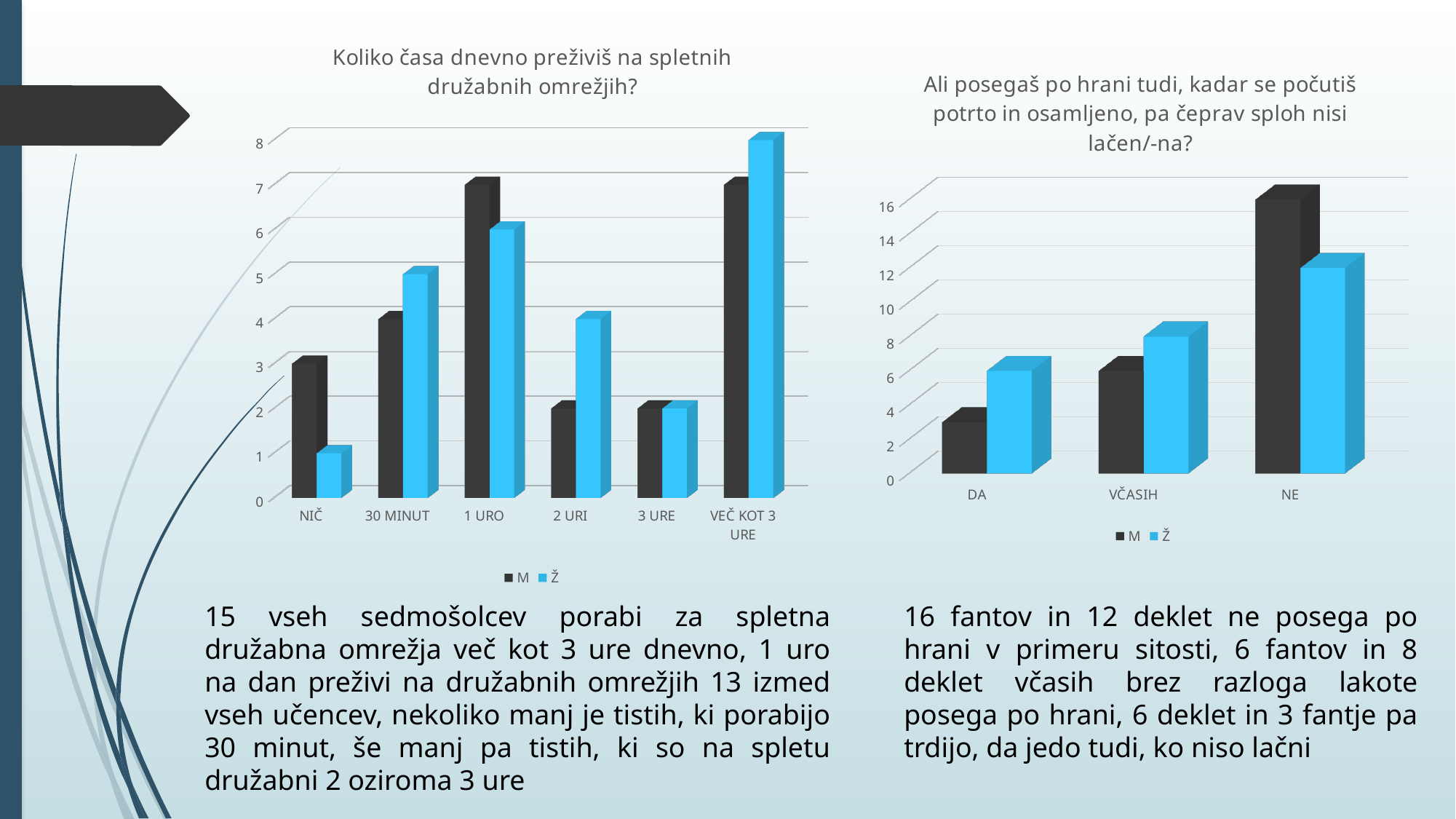
In the chart titled "Koliko časa dnevno preživiš na spletnih družabnih omrežjih?", which is larger in the 30 MINUT category, M or Ž? Ž In the chart titled "Koliko časa dnevno preživiš na spletnih družabnih omrežjih?", how many series does the legend list? 2 In the chart titled "Ali posegaš po hrani tudi, kadar se počutiš potrto in osamljeno...", what is the value for Ž in the DA category? 6 What type of chart is the chart on the right side of the slide? Bar chart In the chart titled "Ali posegaš po hrani tudi, kadar se počutiš potrto in osamljeno...", what is the value for Ž in the VČASIH category? 8 In the chart titled "Ali posegaš po hrani tudi, kadar se počutiš potrto in osamljeno...", what is the value for M in the NE category? 16 In the chart titled "Koliko časa dnevno preživiš na spletnih družabnih omrežjih?", how many categories are shown on the x axis? 6 In the chart titled "Koliko časa dnevno preživiš na spletnih družabnih omrežjih?", is the value for Ž in the NIČ category greater or less than 2? less In the chart titled "Ali posegaš po hrani tudi, kadar se počutiš potrto in osamljeno...", what is the difference between M and Ž in the NE category? 4 In the chart titled "Ali posegaš po hrani tudi, kadar se počutiš potrto in osamljeno...", which category has the highest value for M? NE In the chart titled "Ali posegaš po hrani tudi, kadar se počutiš potrto in osamljeno...", how many categories are shown on the x axis? 3 In the chart titled "Koliko časa dnevno preživiš na spletnih družabnih omrežjih?", is the value for Ž in the VEČ KOT 3 URE category greater or less than 7? greater